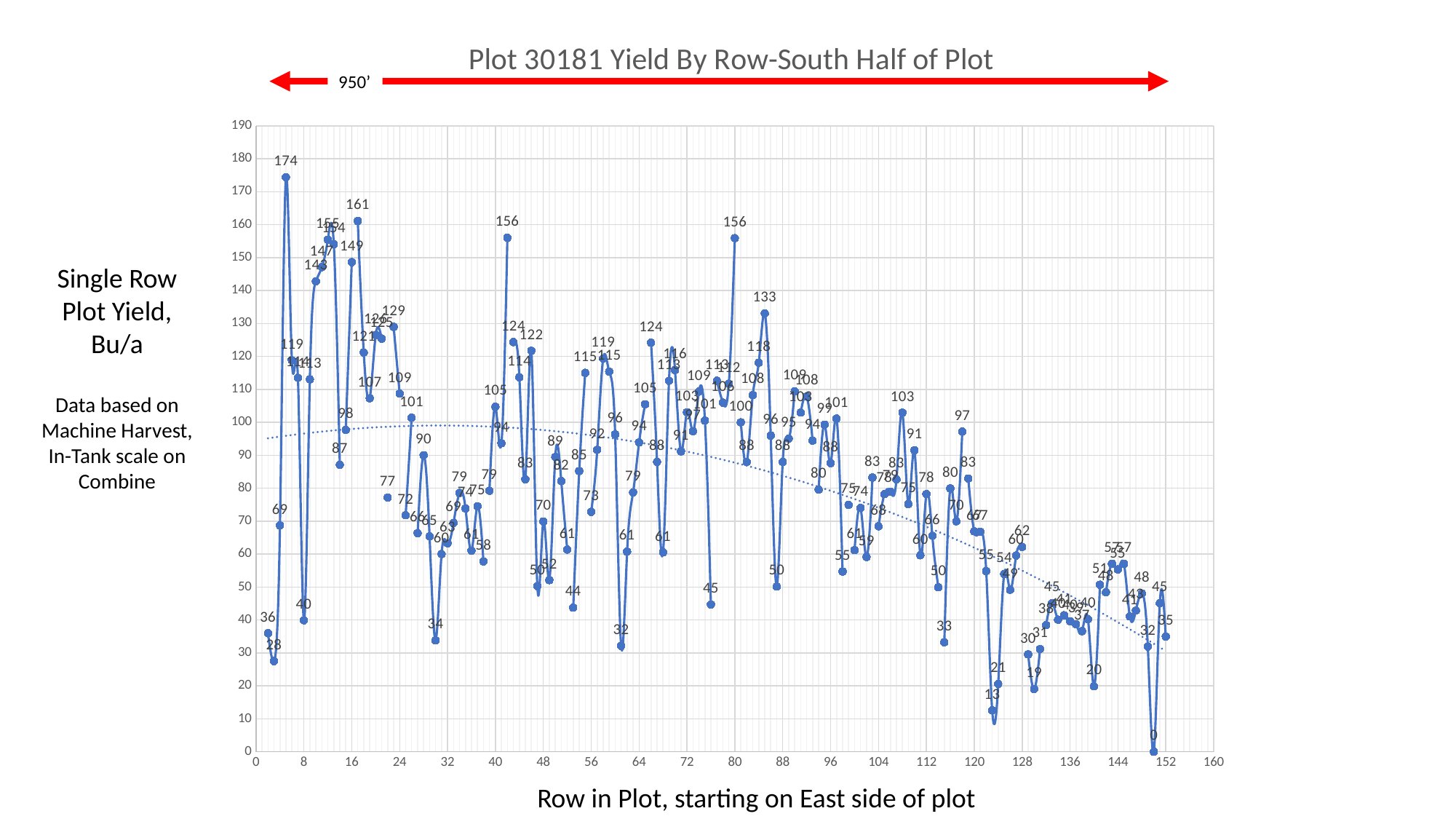
What is the yield value labeled for the first (leftmost) row on the chart? 36 What is the highest single-row yield value labeled on the chart? 174 What kind of chart is shown on the slide? line chart Is the highest yield value on the chart greater or less than 170? greater Which is larger, the peak labeled 174 or the peak labeled 156? 174 What is the difference between the highest labeled value (174) and the second-highest labeled value (161)? 13 What is the x-axis title of the chart? Row in Plot, starting on East side of plot Do the yield values generally rise or fall as the row number increases along the x axis? fall What is the title of the chart? Plot 30181 Yield By Row-South Half of Plot What is the yield value labeled at the tall peak near row 80? 156 Is the yield value for the leftmost row greater or less than 40? less What is the lowest single-row yield value labeled on the chart? 0